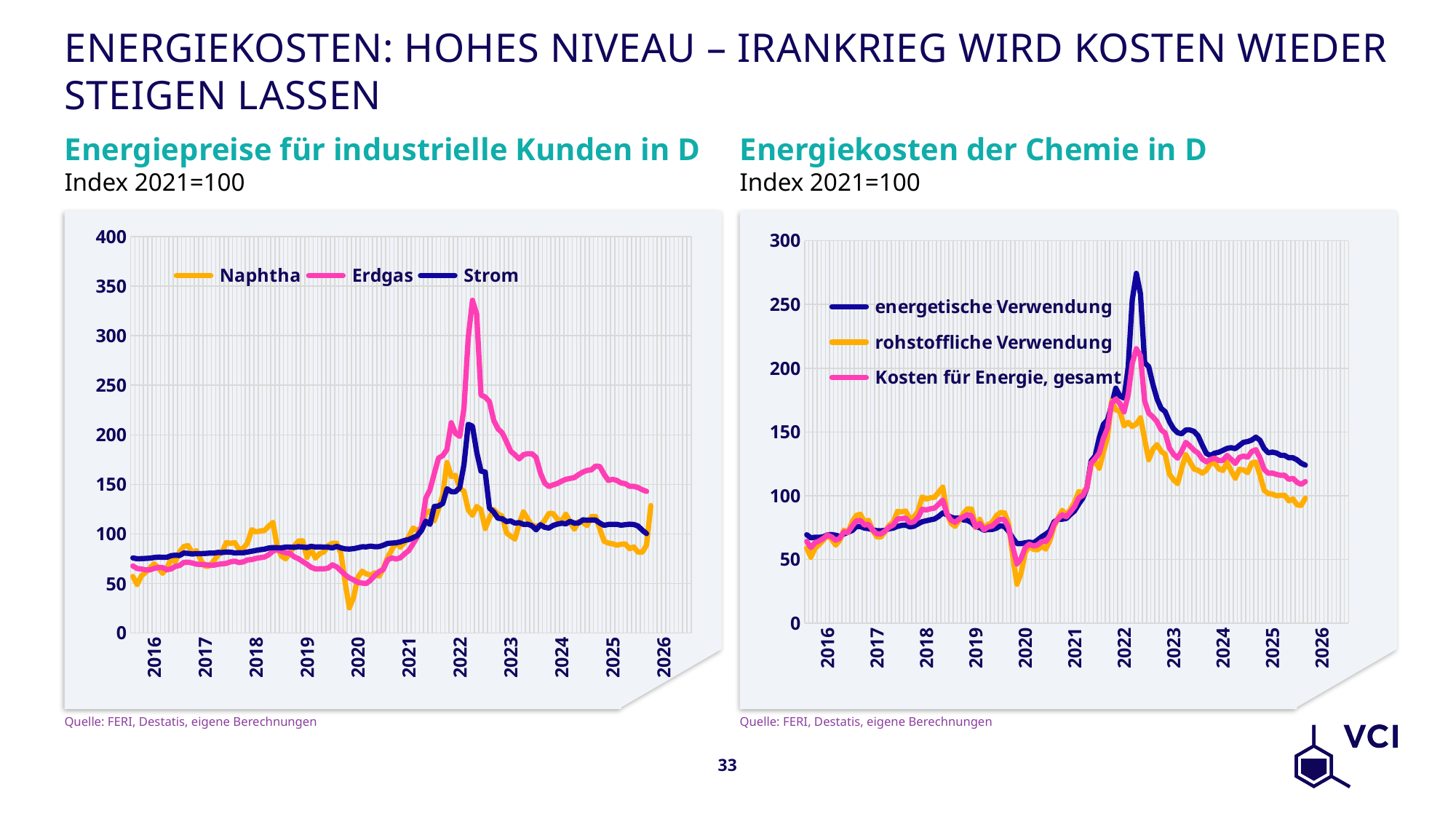
In the right chart 'Energiekosten der Chemie in D', is the lowest value of rohstoffliche Verwendung in 2020 greater or less than 50? less What index base is stated under the titles of both charts? Index 2021=100 In the left chart 'Energiepreise für industrielle Kunden in D', is the peak value of Erdgas in 2022 greater or less than 300? greater In the left chart 'Energiepreise für industrielle Kunden in D', is the lowest value of Naphtha in 2020 greater or less than 50? less In the left chart 'Energiepreise für industrielle Kunden in D', which series has the lowest value around 2020, Naphtha or Strom? Naphtha How many series does the legend of the right chart 'Energiekosten der Chemie in D' list? 3 In the right chart 'Energiekosten der Chemie in D', which series reaches the highest peak? energetische Verwendung How many series does the legend of the left chart 'Energiepreise für industrielle Kunden in D' list? 3 In the left chart 'Energiepreise für industrielle Kunden in D', which series reaches the highest peak? Erdgas In the right chart 'Energiekosten der Chemie in D', do the values of energetische Verwendung rise or fall from the 2022 peak to 2025? fall What kind of chart is the left chart, 'Energiepreise für industrielle Kunden in D'? Line chart